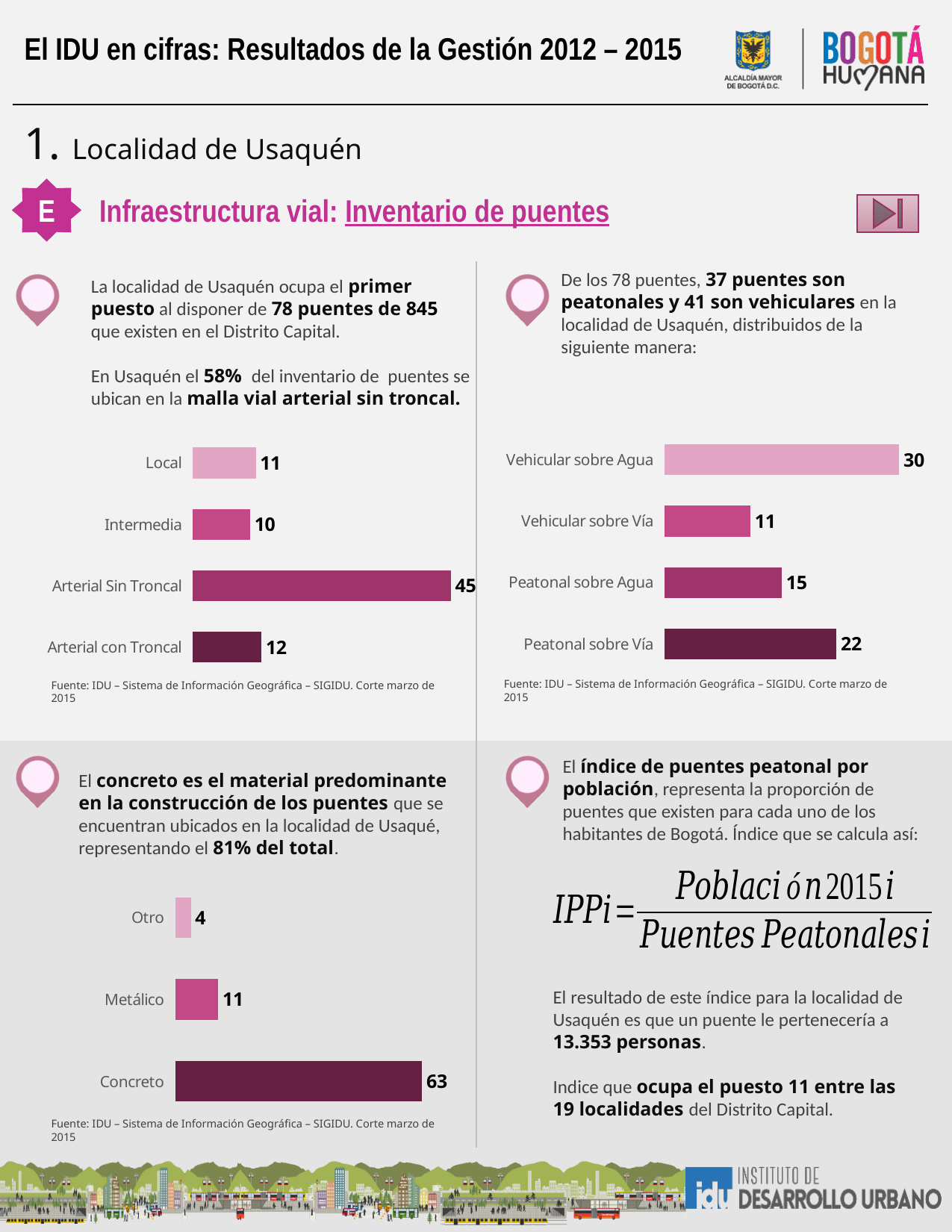
How many categories are shown in the bottom-left bar chart? 3 How many categories are shown in the top-left bar chart? 4 In the top-right bar chart, which is larger: Peatonal sobre Agua or Vehicular sobre Vía? Peatonal sobre Agua In the top-left bar chart, which category has the lowest value? Intermedia In the top-left bar chart, what is the difference between Arterial Sin Troncal and Arterial con Troncal? 33 In the top-right bar chart, what is the difference between Vehicular sobre Agua and Peatonal sobre Agua? 15 In the bottom-left bar chart, which category has the lowest value? Otro In the top-left bar chart, what is the value for Arterial Sin Troncal? 45 What type of chart is the bottom-left chart? Bar chart In the top-right bar chart, which category has the highest value? Vehicular sobre Agua In the bottom-left bar chart, what is the value for Concreto? 63 In the top-right bar chart, what is the value for Peatonal sobre Vía? 22